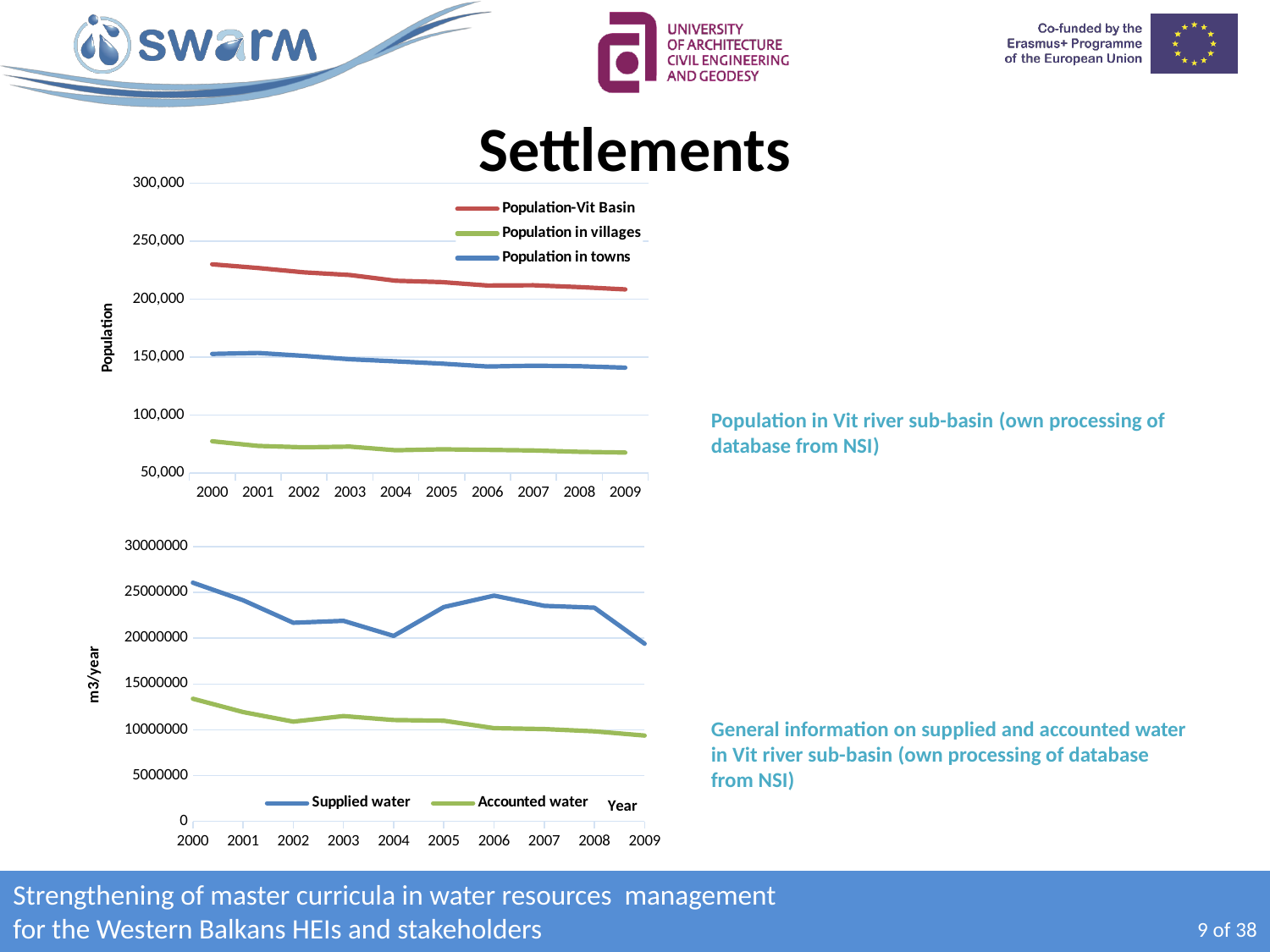
In the top chart, does the Population-Vit Basin series rise or fall from 2000 to 2009? fall What is the y-axis title of the bottom chart? m3/year How many series does the legend of the bottom chart list? 2 In the bottom chart, is the value for Supplied water in 2009 greater or less than 20000000? less In the top chart, is the value for Population-Vit Basin in 2000 greater or less than 200,000? greater How many series does the legend of the top chart list? 3 In the bottom chart, which series is larger in 2006, Supplied water or Accounted water? Supplied water In the top chart, which series has the lowest values across all years? Population in villages What kind of chart is the top chart on the slide? line chart How many years are shown on the x axis of the bottom chart? 10 In the bottom chart, which year has the highest value for Supplied water? 2000 In the top chart, is the value for Population in villages in 2000 greater or less than 100,000? less